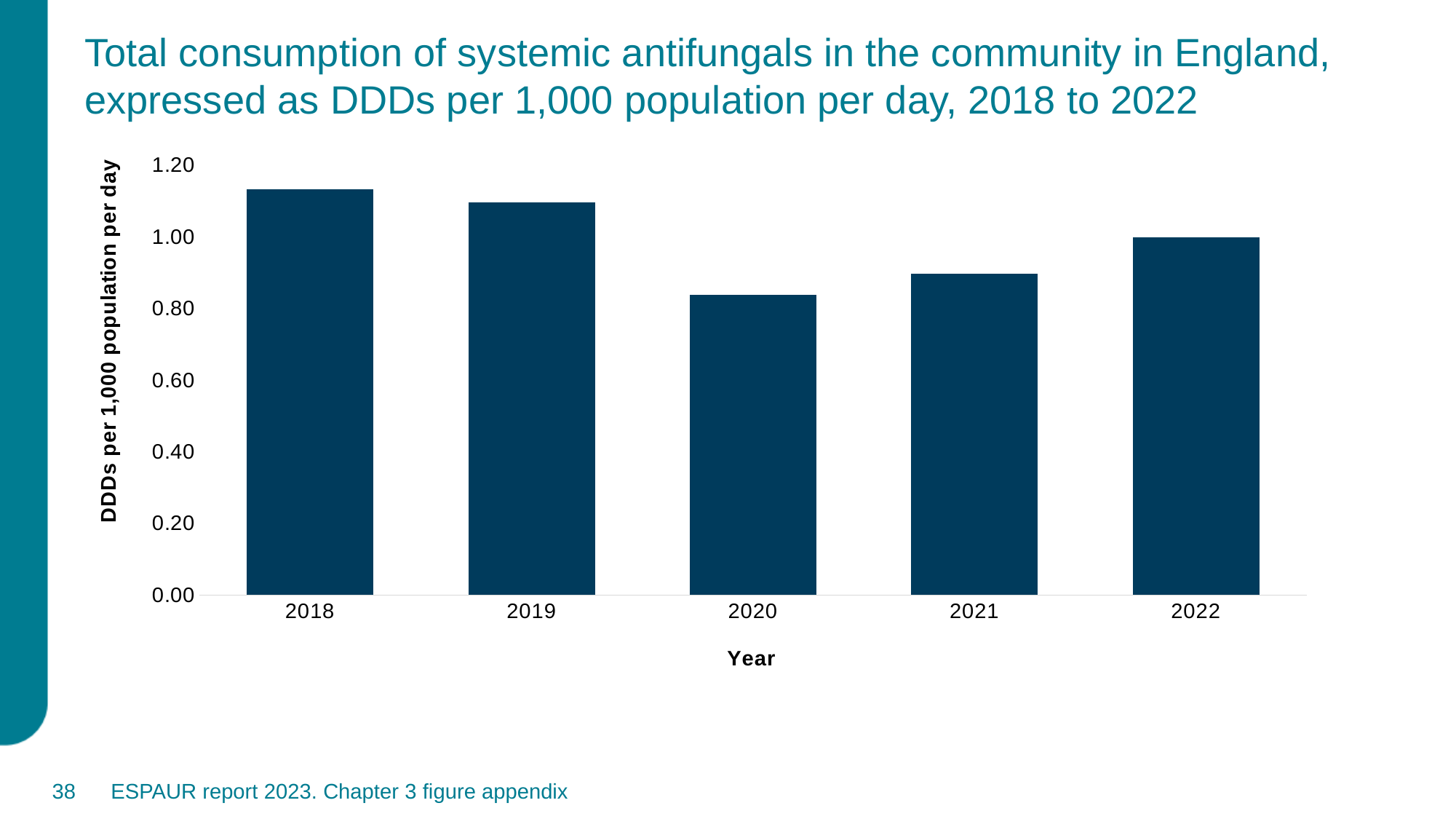
How many years are plotted on the chart? 5 Do the values rise or fall from 2018 to 2020? fall Is the value for 2018 greater or less than 1.00? greater Is the value for 2021 greater or less than 0.80? greater Which year has the highest consumption of systemic antifungals? 2018 Which year has the larger value, 2020 or 2021? 2021 Is the value for 2019 greater or less than 1.20? less What type of chart is shown on the slide? bar chart Which year has the lowest consumption of systemic antifungals? 2020 What is the label of the y axis? DDDs per 1,000 population per day Which year has the larger value, 2022 or 2021? 2022